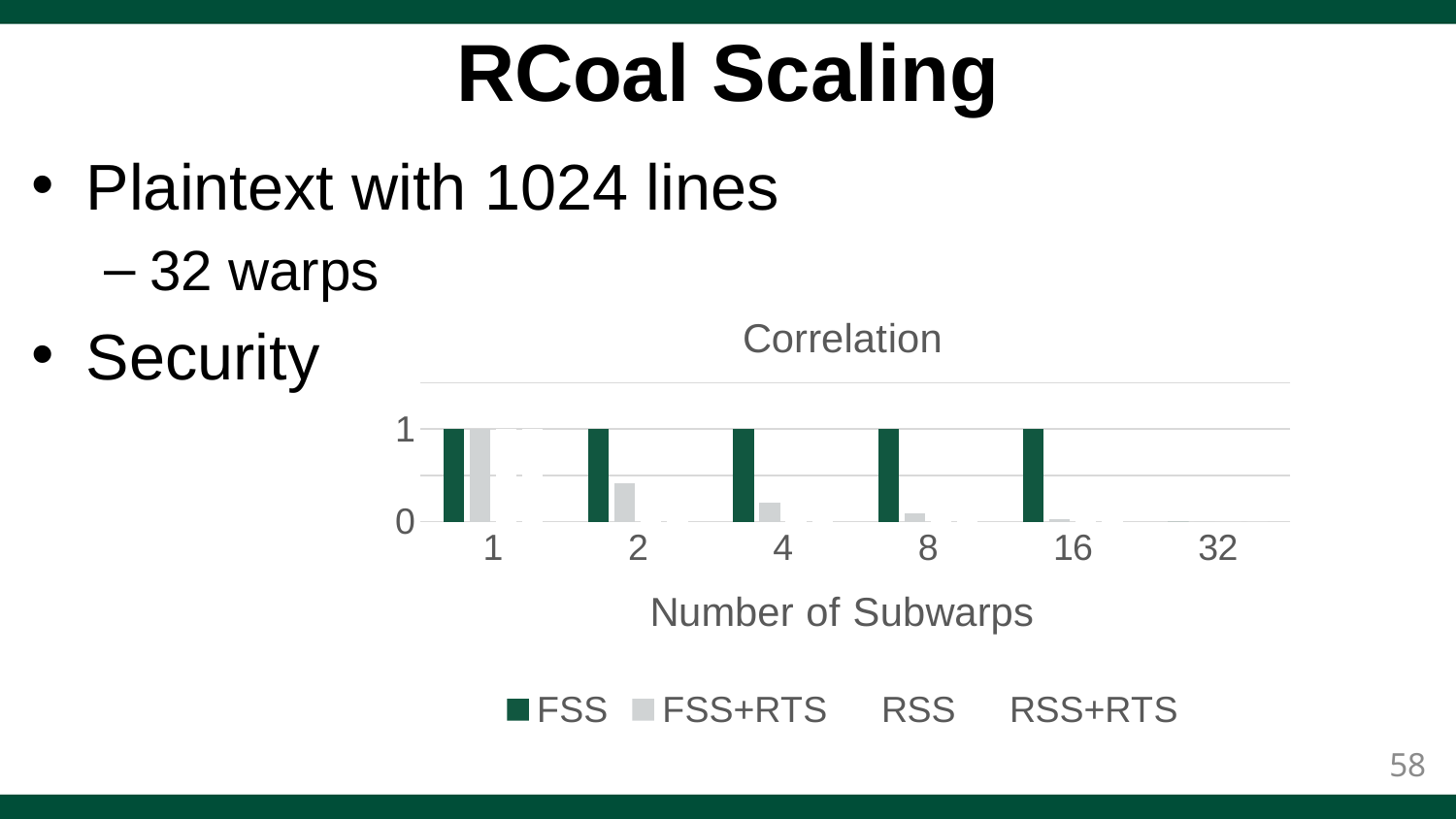
At which number of subwarps is the FSS+RTS value highest? 1 How many categories are shown on the x axis? 6 Do the FSS+RTS values rise or fall as the number of subwarps increases? fall What is the FSS+RTS value at 1 subwarp? 1 What is the FSS value at 1 subwarp? 1 How many series does the legend list? 4 Which is larger at 4 subwarps, FSS or FSS+RTS? FSS What is the FSS value at 8 subwarps? 1 What kind of chart is shown on the slide? bar chart What is the title of the chart? Correlation Is the FSS+RTS value at 2 subwarps greater or less than 1? less What is the x-axis title of the chart? Number of Subwarps